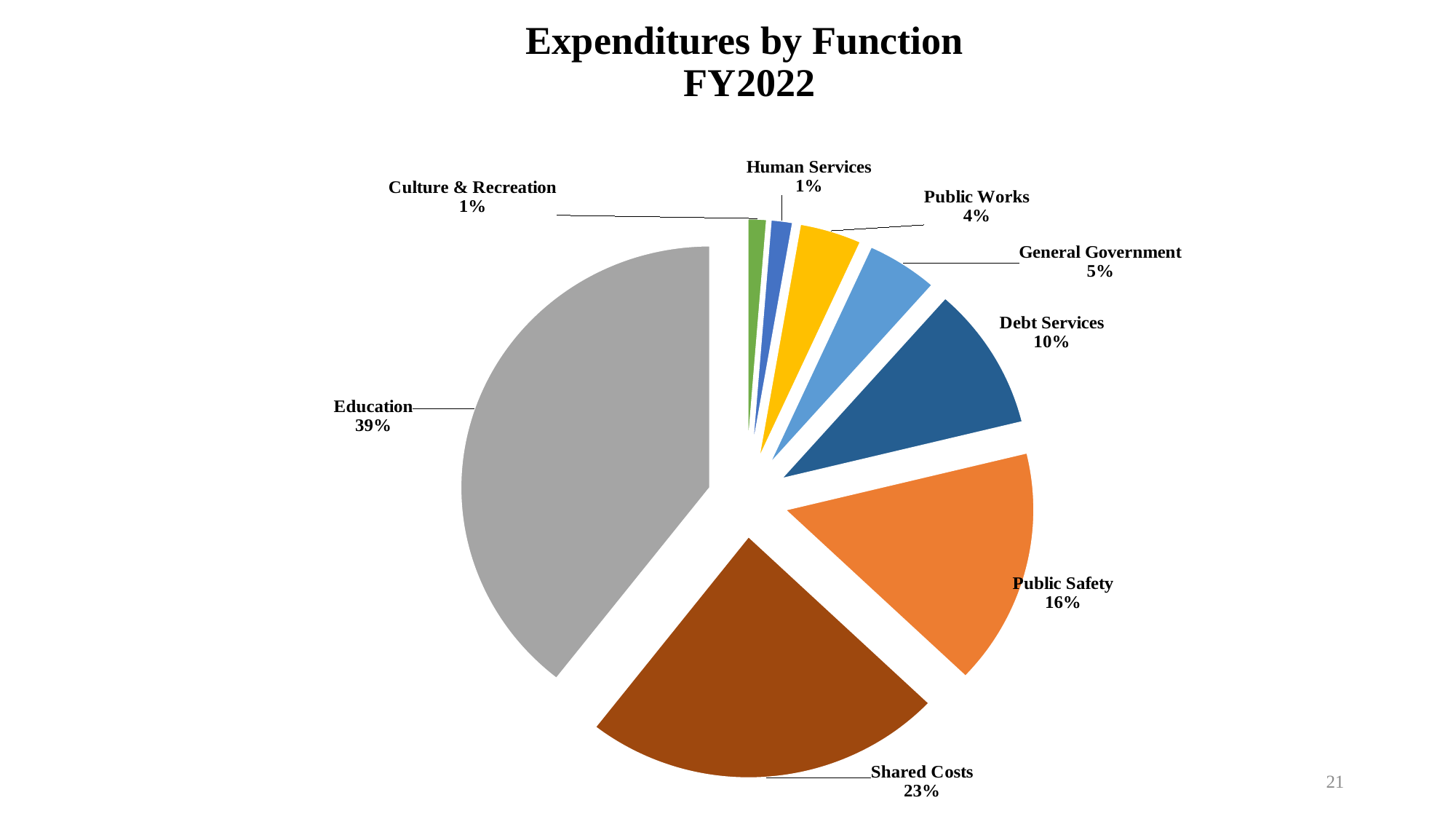
What share of expenditures goes to Education? 39% What colour is the Education slice? Grey Which function has the larger share, Public Safety or General Government? Public Safety What is the difference in percentage points between Public Safety and Debt Services? 6 What percentage of expenditures is Shared Costs? 23% What type of chart is shown on the slide? Pie chart What is the difference in percentage points between Education and Shared Costs? 16 What share of expenditures is Debt Services? 10% How many functions are shown in the pie chart? 8 What is the title of the chart? Expenditures by Function FY2022 Which function has the largest share of expenditures? Education What percentage is shown for Public Works? 4%